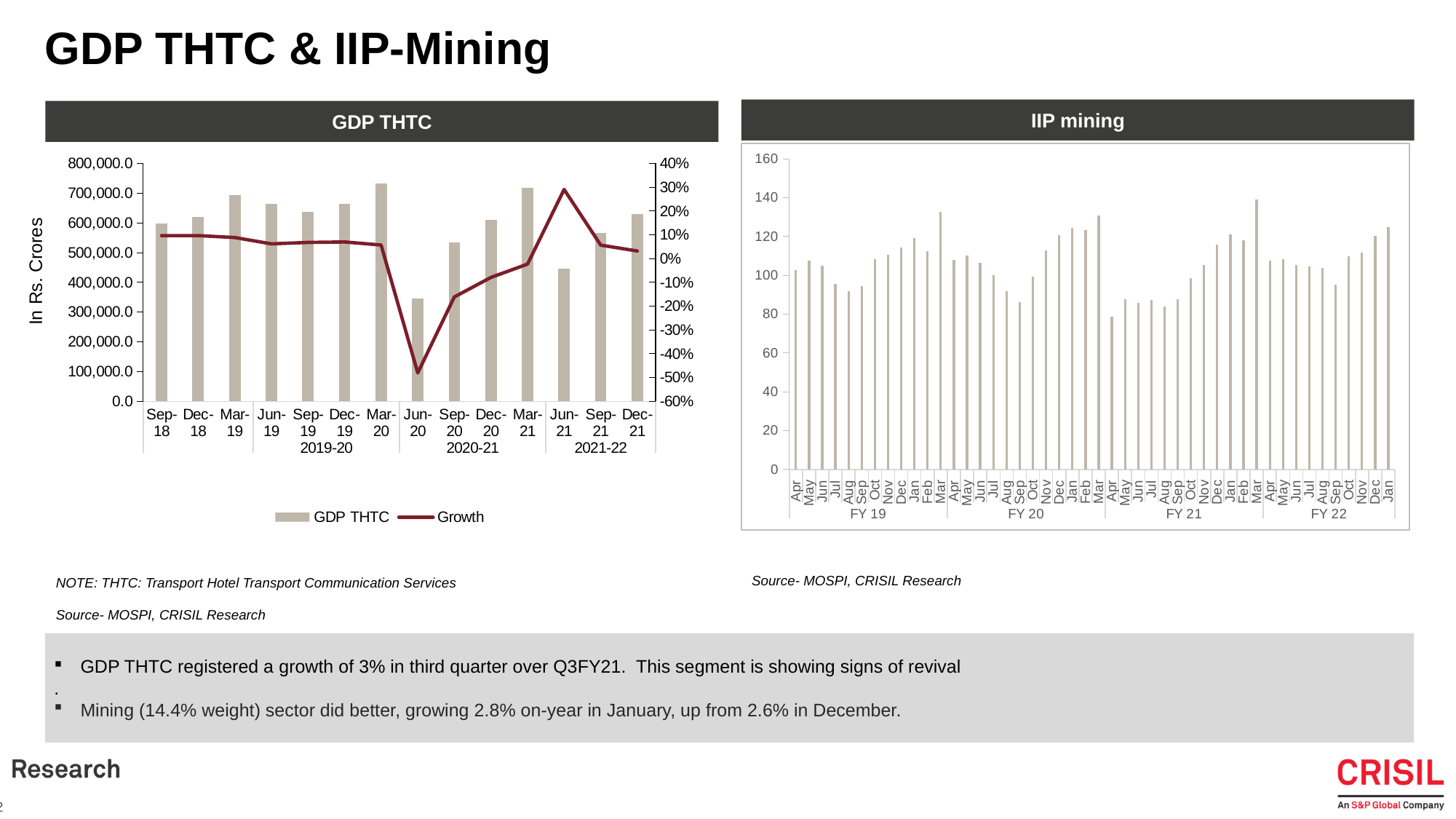
On the GDP THTC chart, is the Growth value for Jun-21 greater or less than 20%? greater On the GDP THTC chart, what is the label on the left vertical axis? In Rs. Crores On the GDP THTC chart, how many quarters are plotted on the x axis? 14 On the IIP mining chart, which month has the highest bar? Mar FY 21 On the GDP THTC chart, which quarter has the lowest GDP THTC bar? Jun-20 On the GDP THTC chart, in which quarter does the Growth line reach its highest point? Jun-21 On the GDP THTC chart, what kind of chart is used? A bar chart combined with a line chart On the GDP THTC chart, in which quarter does the Growth line reach its lowest point? Jun-20 On the GDP THTC chart, which is larger, the GDP THTC bar for Jun-20 or for Jun-21? Jun-21 On the GDP THTC chart, is the GDP THTC value for Jun-20 greater or less than 400,000.0? less On the GDP THTC chart, is the GDP THTC value for Mar-20 greater or less than 700,000.0? greater On the GDP THTC chart, how many series does the legend list? 2